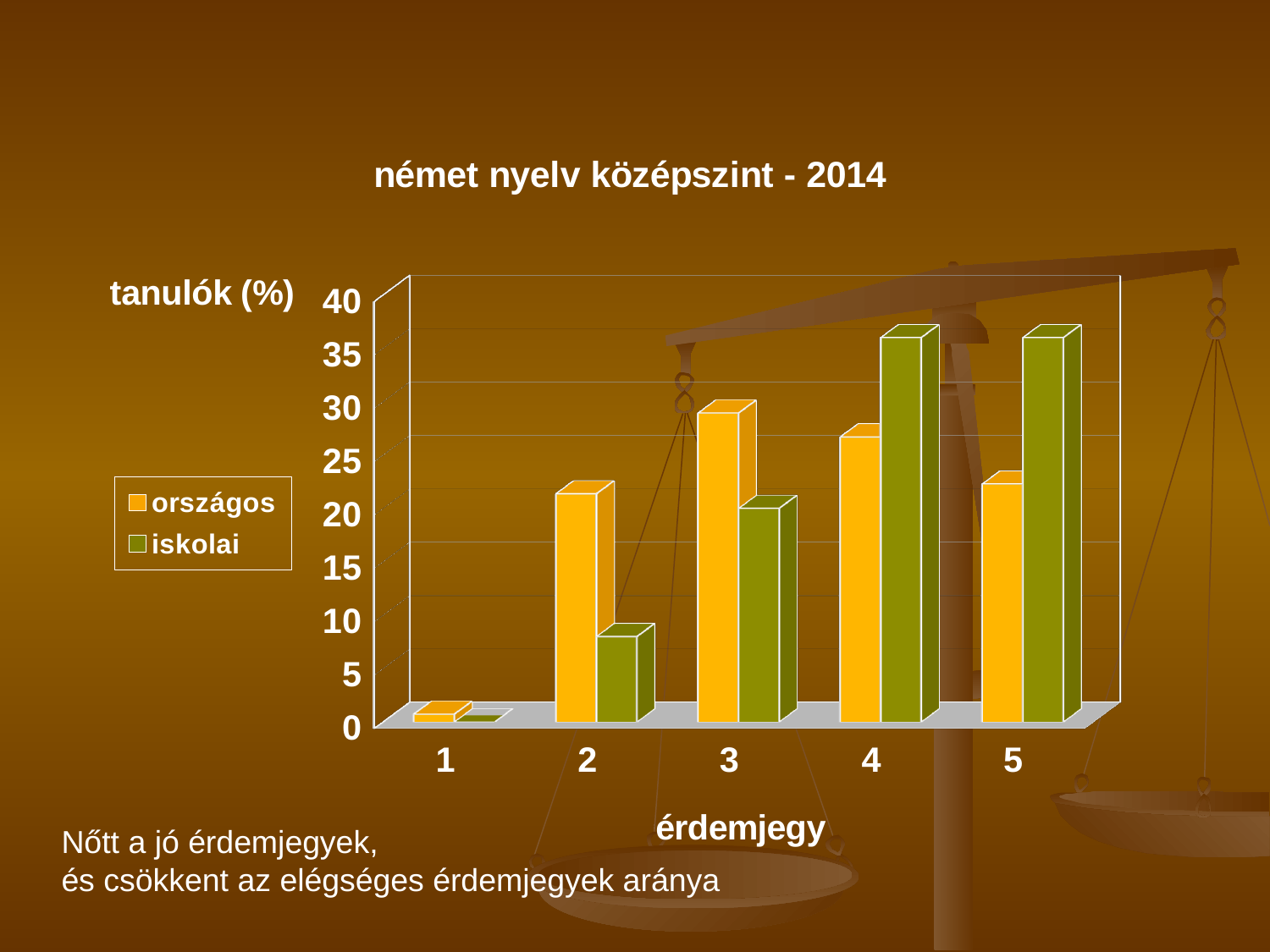
How many series does the legend list? 2 For grade 5, which series has the larger value, országos or iskolai? iskolai For grade 4, which series has the larger value, országos or iskolai? iskolai Is the iskolai value for grade 2 greater or less than 10? less Is the országos value for grade 3 greater or less than 25? greater For grade 2, which series has the larger value, országos or iskolai? országos Which grade has the lowest országos value? 1 Is the iskolai value for grade 4 greater or less than 30? greater What is the title of the chart? német nyelv középszint - 2014 How many grade categories (érdemjegy) are shown on the x axis? 5 What are the two series named in the legend? országos, iskolai What kind of chart is shown on the slide? bar chart